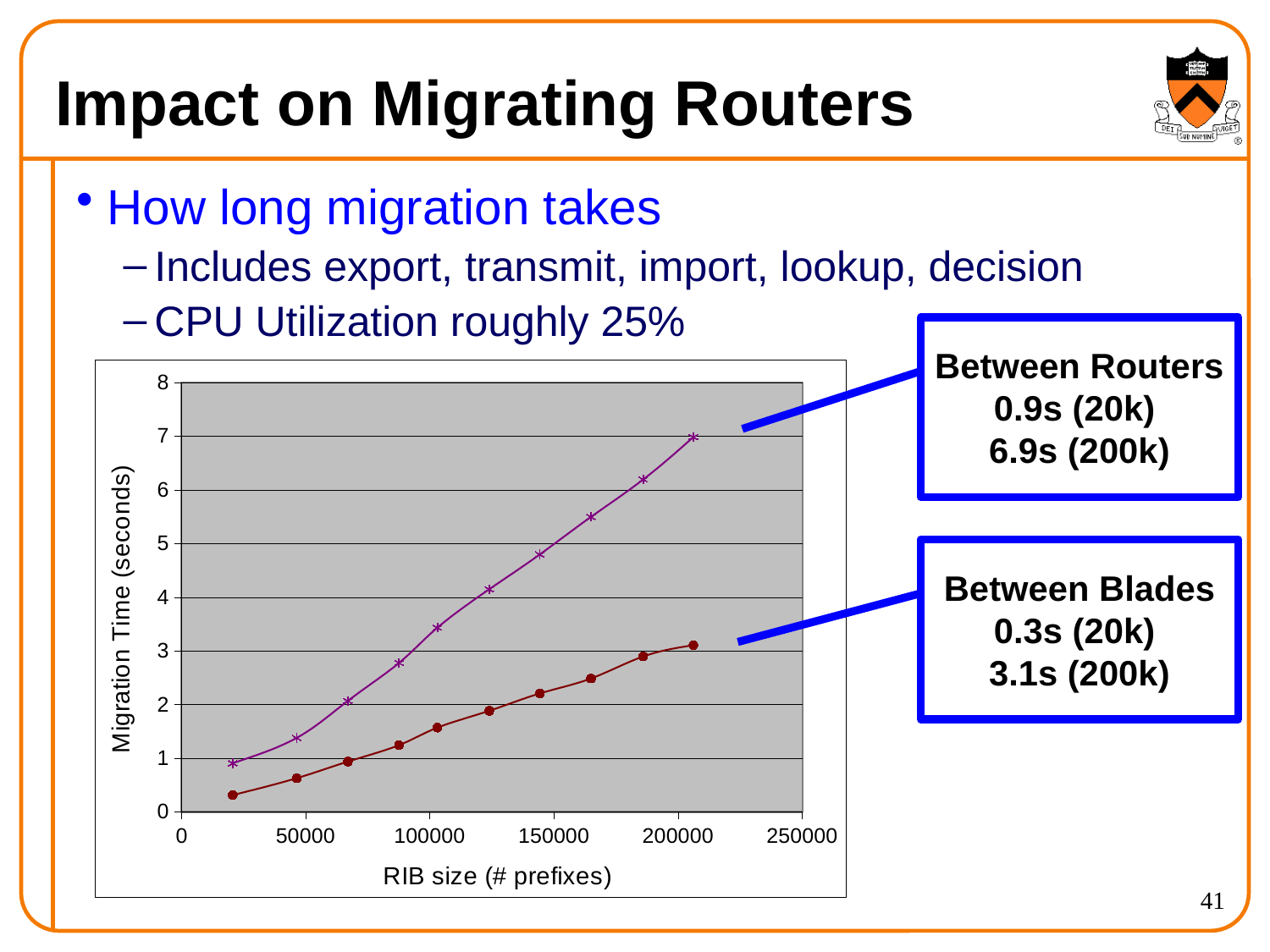
Is the between-blades migration time at a RIB size of 150000 greater or less than 3 seconds? less What is the migration time between blades at a RIB size of 20k prefixes? 0.3s At 200k prefixes, how much longer is migration between routers than between blades? 3.8s What is the label of the y axis of the chart? Migration Time (seconds) What is the migration time between routers at a RIB size of 200k prefixes? 6.9s What kind of chart is shown on the slide? line chart Does migration time rise or fall as RIB size increases? rises What is the migration time between blades at a RIB size of 200k prefixes? 3.1s Is the between-routers migration time at a RIB size of 150000 greater or less than 4 seconds? greater How much does the between-routers migration time increase from 20k to 200k prefixes? 6.0s What is the migration time between routers at a RIB size of 20k prefixes? 0.9s At 20k prefixes, which takes longer: migration between routers or between blades? Between Routers